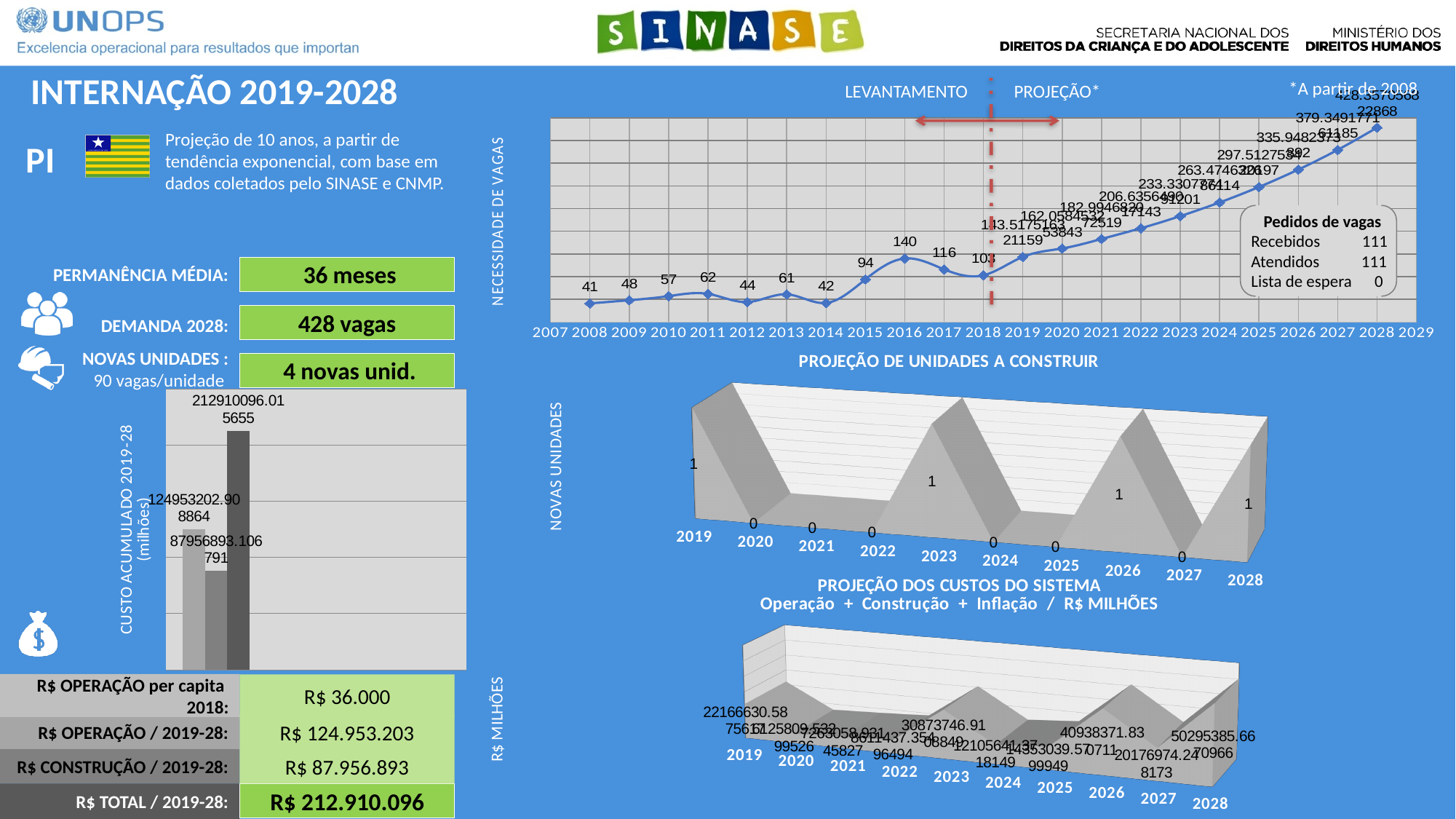
In the top line chart (NECESSIDADE DE VAGAS), which is larger, the value for 2011 or the value for 2013? 2011 In the top line chart (NECESSIDADE DE VAGAS), which year has the lowest value? 2008 What kind of chart is the top chart (NECESSIDADE DE VAGAS)? line chart In the top line chart (NECESSIDADE DE VAGAS), what is the value for 2008? 41 In the top line chart (NECESSIDADE DE VAGAS), what is the value for 2018? 103 In the top line chart (NECESSIDADE DE VAGAS), what is the difference between the values for 2016 and 2017? 24 In the chart titled PROJEÇÃO DE UNIDADES A CONSTRUIR, how many years are shown on the x axis? 10 In the top line chart (NECESSIDADE DE VAGAS), what is the value for 2016? 140 In the top line chart (NECESSIDADE DE VAGAS), do the values rise or fall from 2018 to 2028? rise In the chart titled PROJEÇÃO DE UNIDADES A CONSTRUIR, what is the value for 2023? 1 In the top line chart (NECESSIDADE DE VAGAS), which year has the highest value? 2028 In the top line chart (NECESSIDADE DE VAGAS), what is the value for 2015? 94